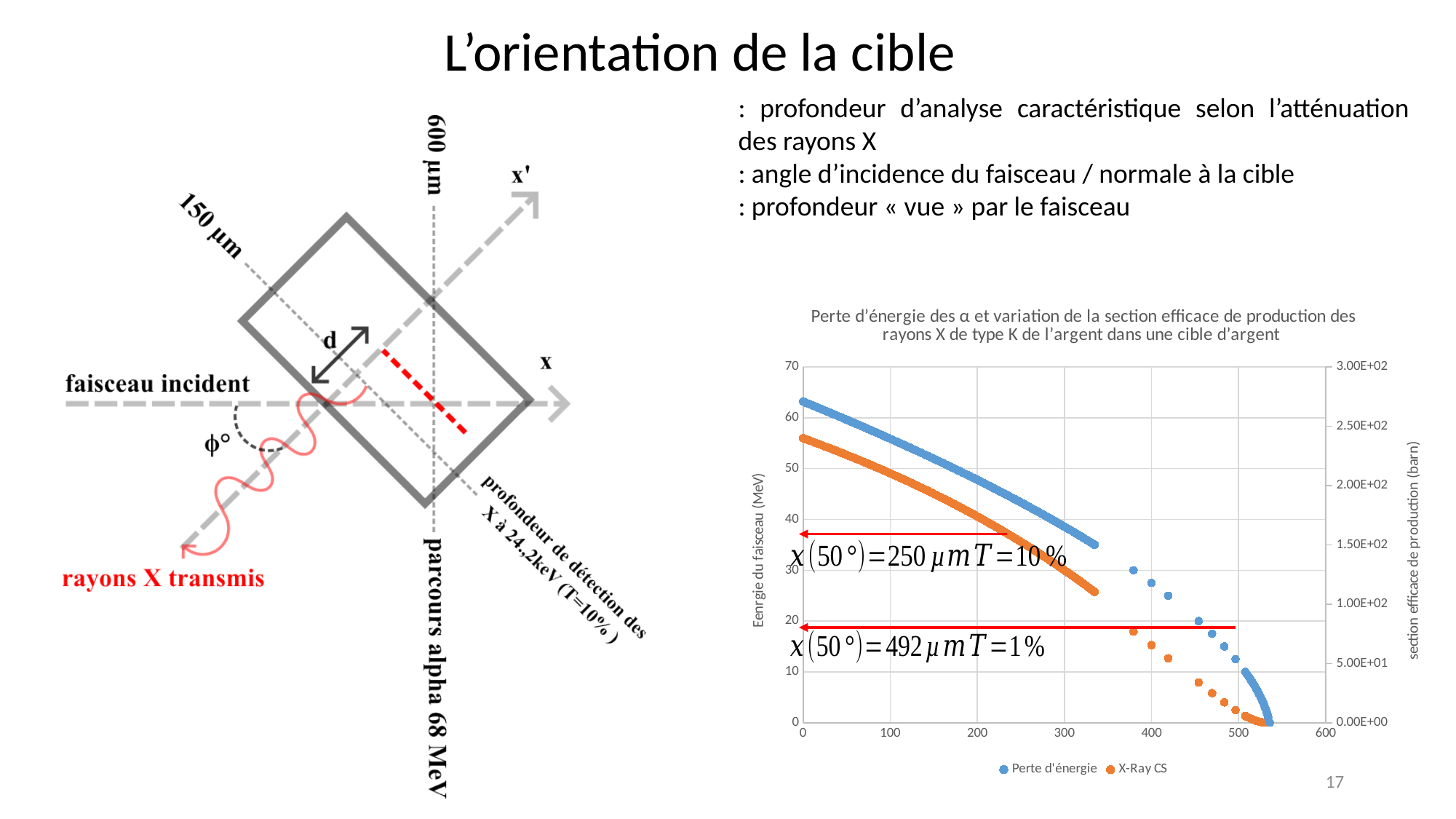
What is the label of the left vertical axis of the chart? Eenrgie du faisceau (MeV) Does the 'Perte d'énergie' series rise or fall as the x-axis value increases? fall Is the value of the 'Perte d'énergie' series at x = 300 greater or less than 50 MeV? less What are the two series named in the chart's legend? Perte d'énergie and X-Ray CS Is the value of the 'Perte d'énergie' series at x = 0 greater or less than 50 MeV? greater How many series does the chart's legend list? 2 Does the 'X-Ray CS' series rise or fall as the x-axis value increases? fall What kind of chart is shown on the slide? scatter chart Is the value of the 'Perte d'énergie' series at x = 500 greater or less than 30 MeV? less What is the maximum value shown on the right vertical axis of the chart? 3.00E+02